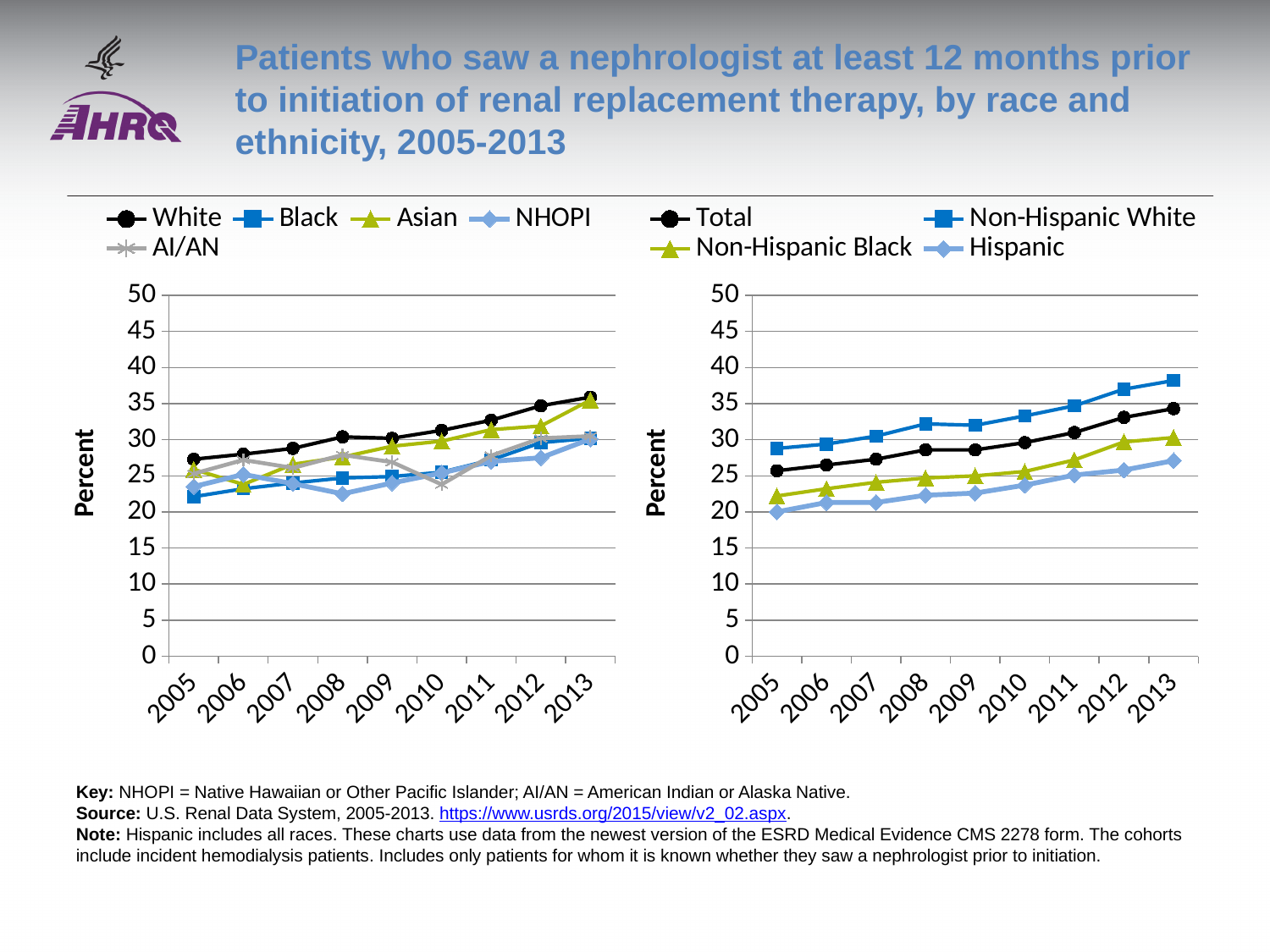
In the left chart, is the value for White in 2012 greater or less than 30? greater In the left chart, is the value for Black in 2005 greater or less than 25? less In the left chart, which group has the lowest value in 2005? Black How many years are shown on the x axis of the right chart? 9 In the right chart, which group has the highest value in 2013? Non-Hispanic White In the right chart, is the value for Hispanic in 2005 greater or less than 25? less In the right chart, which group has the lowest value in 2013? Hispanic In the left chart, which group has the highest value in 2005? White In the right chart, does the Non-Hispanic White series generally rise or fall from 2005 to 2013? Rise How many series does the legend of the left chart list? 5 What kind of chart is the left chart (White, Black, Asian, NHOPI, AI/AN)? Line chart How many series does the legend of the right chart list? 4